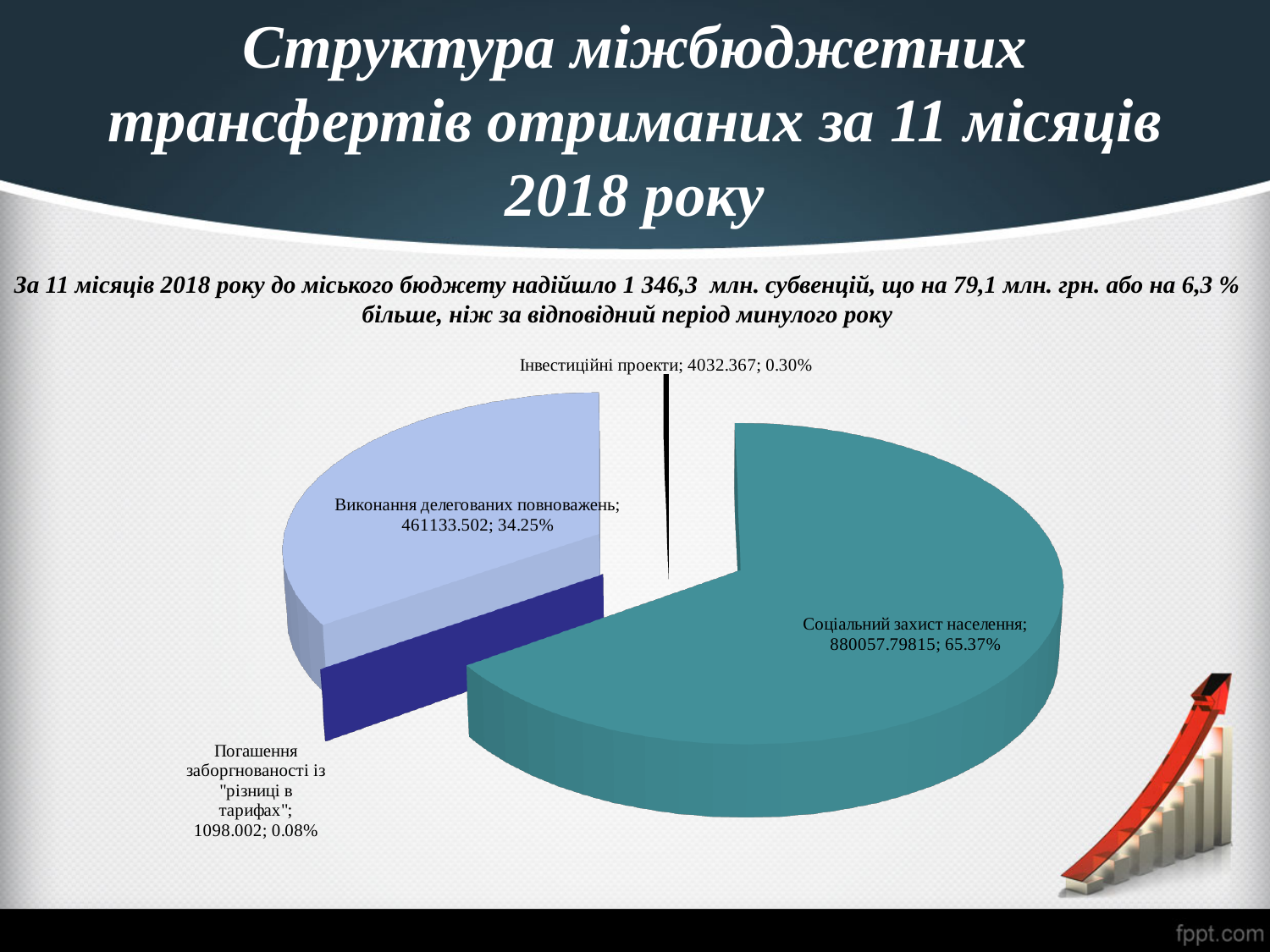
What is the difference in percentage points between the shares of Соціальний захист населення and Виконання делегованих повноважень? 31.12% What percentage is shown for Погашення заборгованості із "різниці в тарифах"? 0.08% Which is larger: the share for Інвестиційні проекти or the share for Погашення заборгованості із "різниці в тарифах"? Інвестиційні проекти What share of the pie does Соціальний захист населення represent? 65.37% Which category has the smallest slice of the pie? Погашення заборгованості із "різниці в тарифах" What percentage is shown for Виконання делегованих повноважень? 34.25% Which category has the largest slice of the pie? Соціальний захист населення What is the value shown for Соціальний захист населення? 880057.79815 What is the value shown for Інвестиційні проекти? 4032.367 What kind of chart is shown on the slide? pie chart What is the value shown for Виконання делегованих повноважень? 461133.502 How many slices does the pie chart have? 4